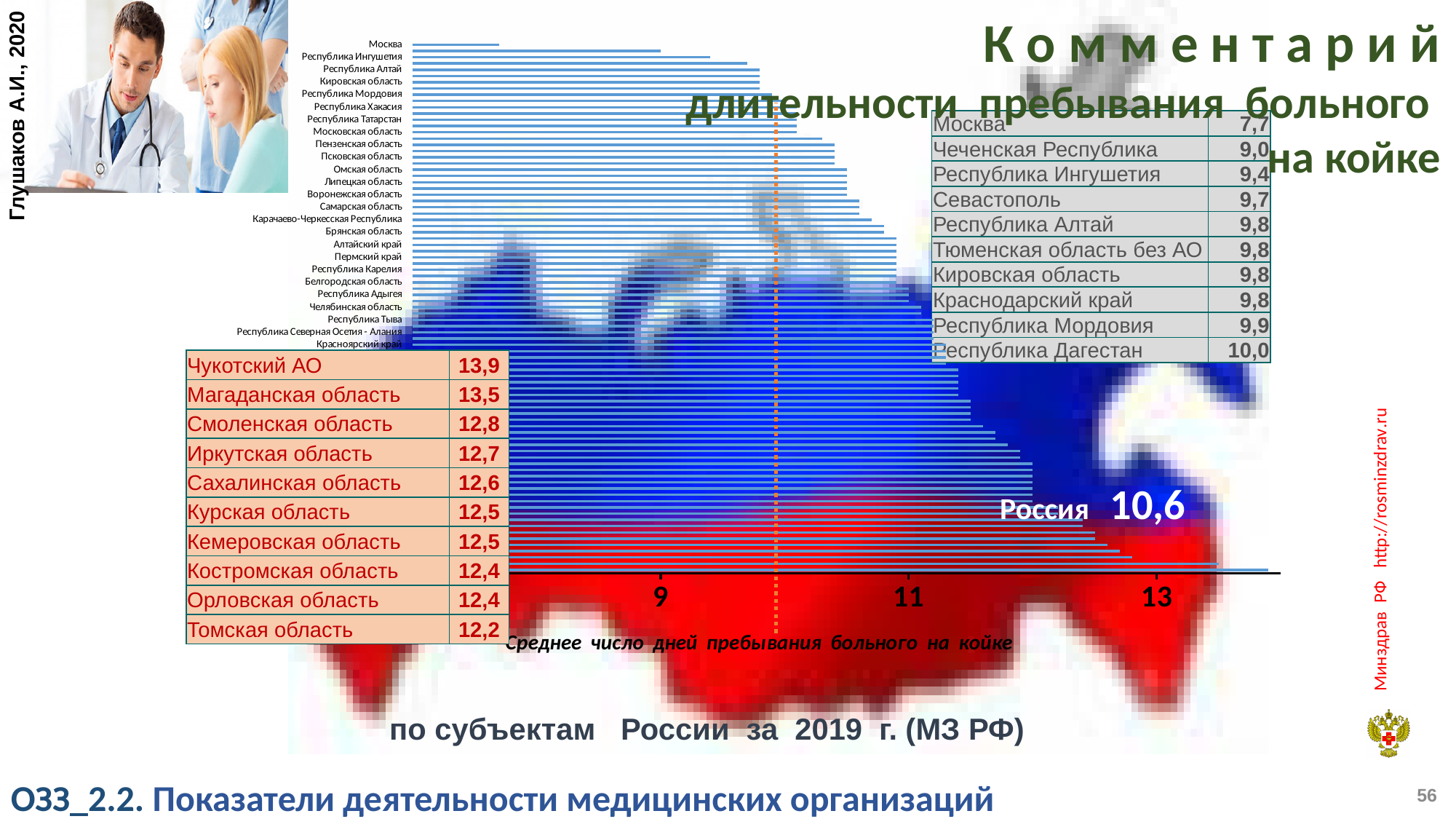
What is the difference between the values for Чукотский АО and Москва? 6,2 Is the value for Москва greater or less than 9? less Which region has the highest average length of stay on the slide? Чукотский АО What is the title of the horizontal axis of the chart? Среднее число дней пребывания больного на койке What kind of chart is shown on the slide? bar chart According to the table on the slide, what is the average length of stay for Москва? 7,7 What is the value for Республика Дагестан in the table? 10,0 Do the bar lengths increase or decrease going from the top of the chart to the bottom? increase According to the table on the slide, what is the value for Чукотский АО? 13,9 What is the value shown for Россия as a whole? 10,6 Which region has the lowest average length of stay on the slide? Москва Which has a larger value, Магаданская область or Смоленская область? Магаданская область